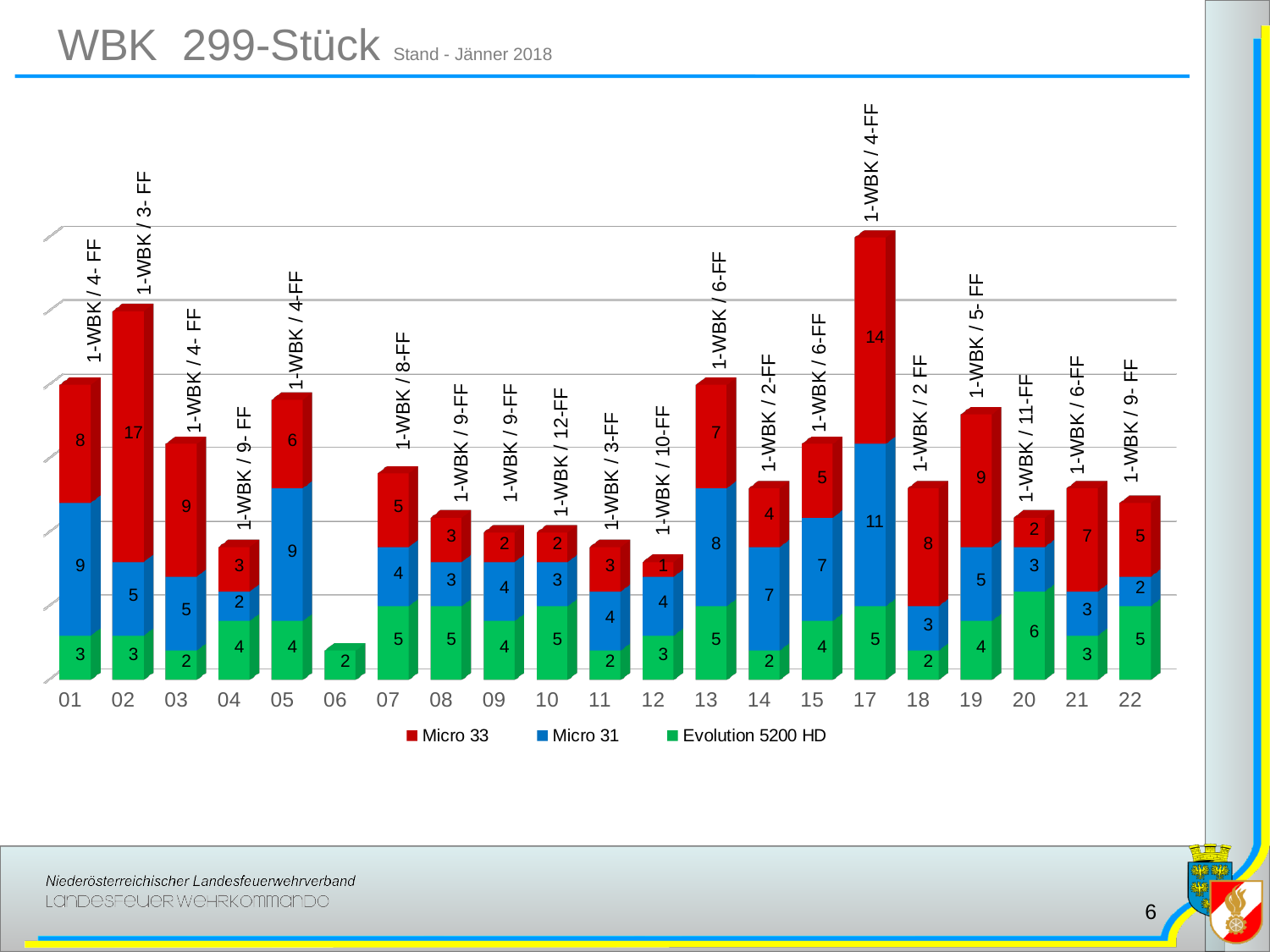
Which is larger, the Micro 31 value for category 13 or for category 14? category 13 What is the Evolution 5200 HD value for category 20? 6 What is the Micro 31 value for category 17? 11 What is the Micro 33 value for category 02? 17 What is the total of the stacked bar for category 17? 30 Which category has the tallest stacked bar? 17 What is the total of the stacked bar for category 01? 20 What kind of chart is shown on the slide? stacked bar chart Which series is shown in red in the legend? Micro 33 How many series does the legend list? 3 Which category has the shortest stacked bar? 06 What is the difference between the Micro 33 values for categories 02 and 01? 9